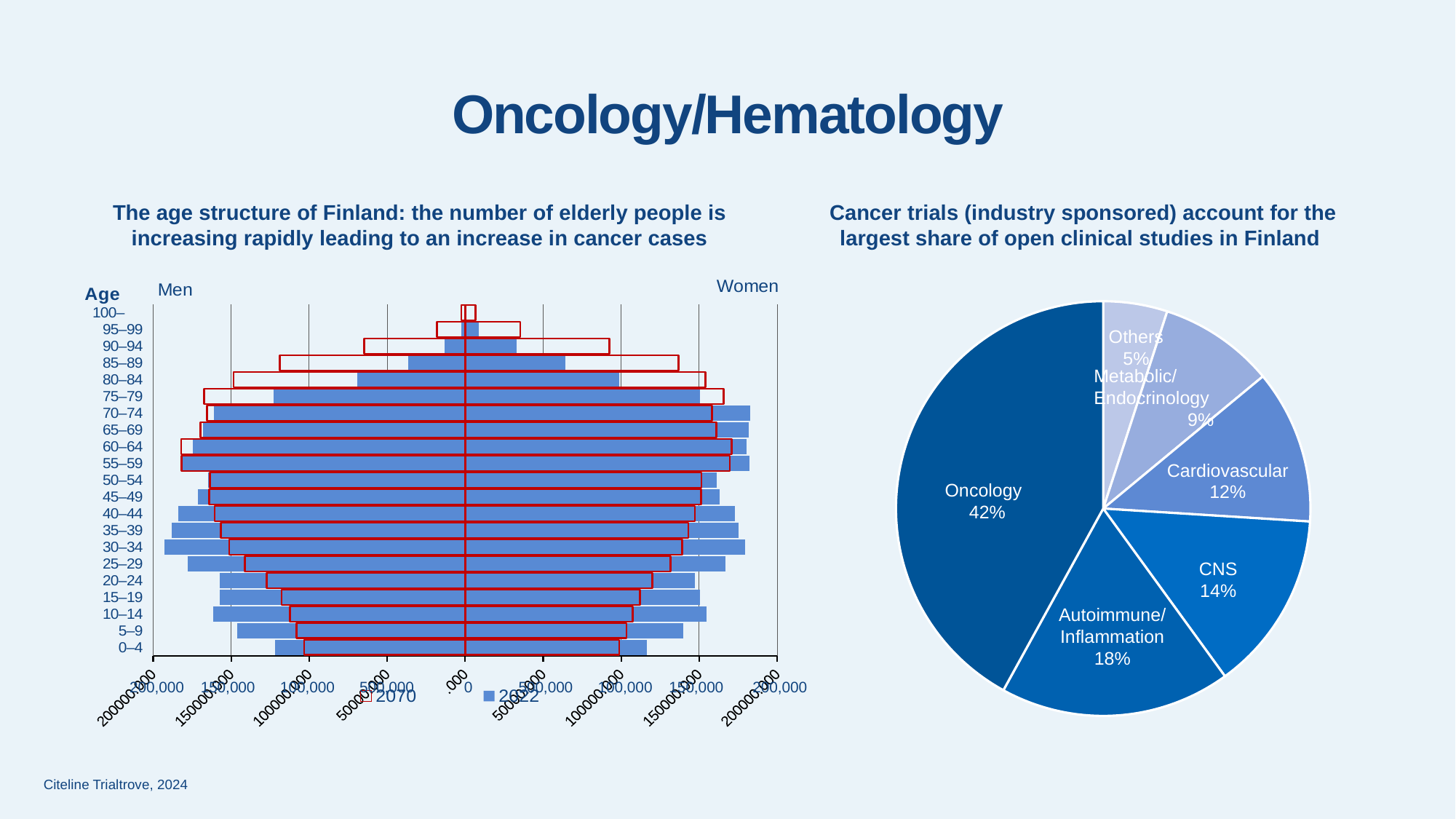
How many slices does the pie chart on the right have? 6 In the pie chart on the right, what is the share for Metabolic/Endocrinology? 9% In the pie chart on the right, what share of open clinical studies is Oncology? 42% What kind of chart is the age structure of Finland chart on the left? Bar chart In the pie chart on the right, which therapeutic area has the largest share? Oncology In the pie chart on the right, what is the difference in percentage points between Oncology and Autoimmune/Inflammation? 24% In the pie chart on the right, which slice is the smallest? Others How many series does the legend of the age structure chart on the left list? 2 In the pie chart on the right, which is larger, CNS or Cardiovascular? CNS What kind of chart is shown on the right side of the slide? Pie chart How many age groups are shown on the age structure chart on the left? 21 In the pie chart on the right, what is the share for Cardiovascular? 12%